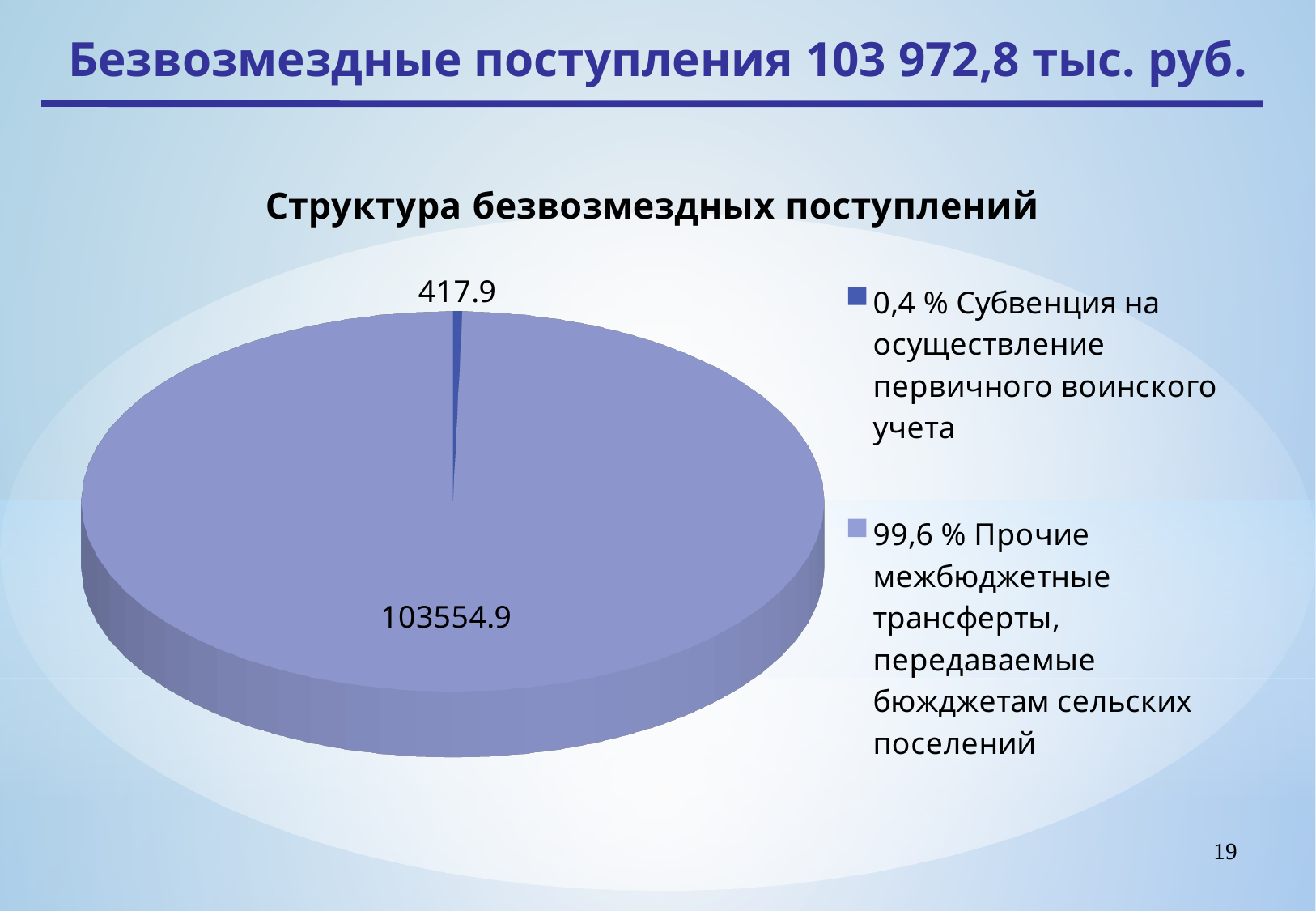
What is the value of the slice for Прочие межбюджетные трансферты, передаваемые бюджетам сельских поселений? 103554.9 How many entries does the legend list? 2 What is the value of the slice for Субвенция на осуществление первичного воинского учета? 417.9 How many slices does the pie chart have? 2 What share of the pie does Субвенция на осуществление первичного воинского учета represent, according to the legend? 0,4 % What type of chart is shown on the slide? pie chart What share of the pie does Прочие межбюджетные трансферты, передаваемые бюджетам сельских поселений represent, according to the legend? 99,6 % Which category has the smallest slice of the pie? Субвенция на осуществление первичного воинского учета What is the title of the chart? Структура безвозмездных поступлений Which category has the largest slice of the pie? Прочие межбюджетные трансферты, передаваемые бюджетам сельских поселений Which is larger: the value for Субвенция на осуществление первичного воинского учета or the value for Прочие межбюджетные трансферты? Прочие межбюджетные трансферты What is the difference between the value for Прочие межбюджетные трансферты and the value for Субвенция на осуществление первичного воинского учета? 103137